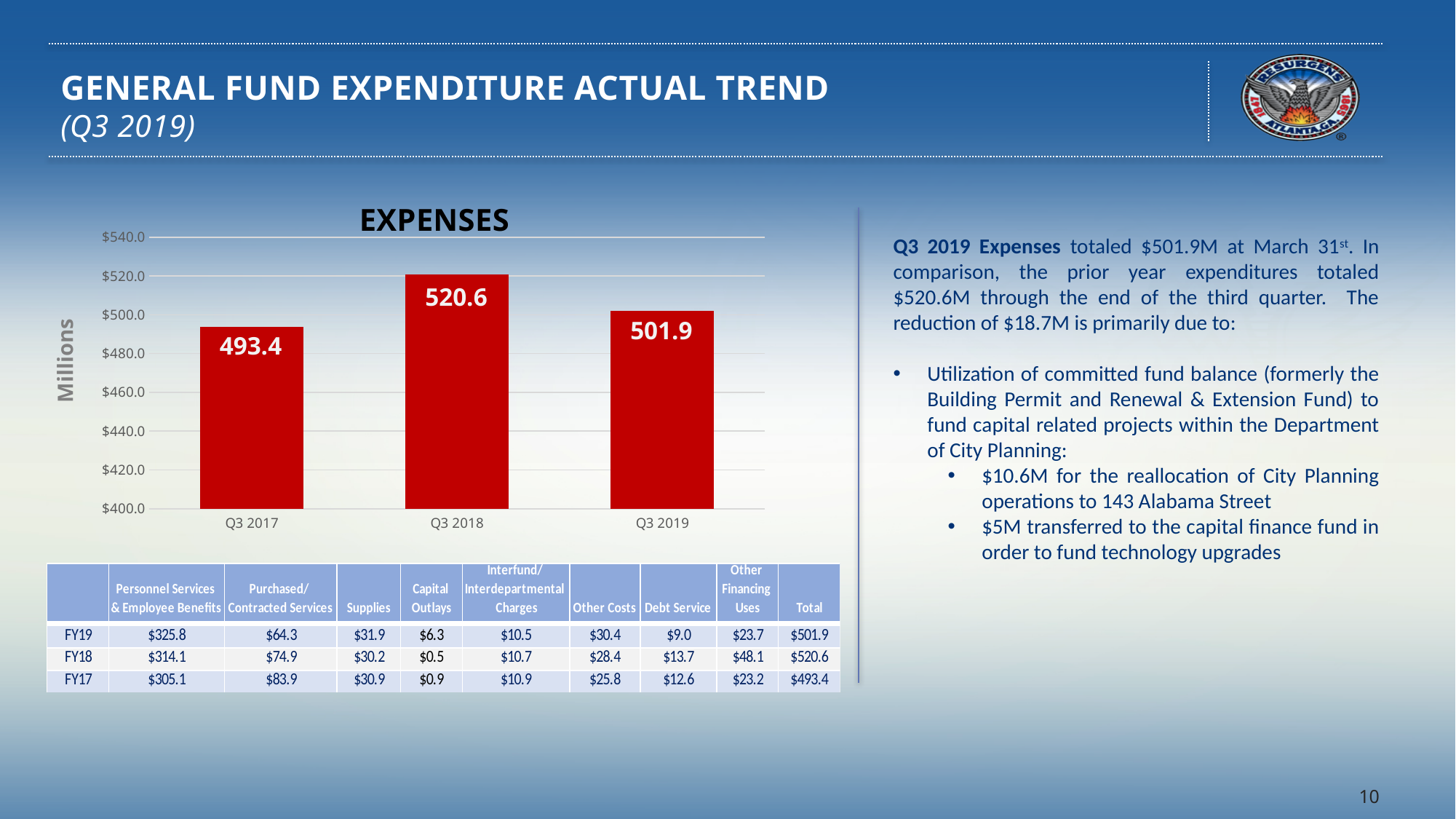
Is the value for Q3 2018 in the EXPENSES chart greater or less than $500.0? greater What is the difference between the Q3 2019 and Q3 2017 values in the EXPENSES chart? 8.5 What is the value for Q3 2017 in the EXPENSES chart? 493.4 How many bars are shown in the EXPENSES chart? 3 What is the value for Q3 2019 in the EXPENSES chart? 501.9 Which is larger in the EXPENSES chart, Q3 2017 or Q3 2019? Q3 2019 What type of chart is the EXPENSES chart? bar chart Which quarter has the lowest expenses in the chart? Q3 2017 What is the value for Q3 2018 in the EXPENSES chart? 520.6 What is the difference between the Q3 2018 and Q3 2019 values in the EXPENSES chart? 18.7 What is the label on the vertical axis of the EXPENSES chart? Millions Which quarter has the highest expenses in the chart? Q3 2018